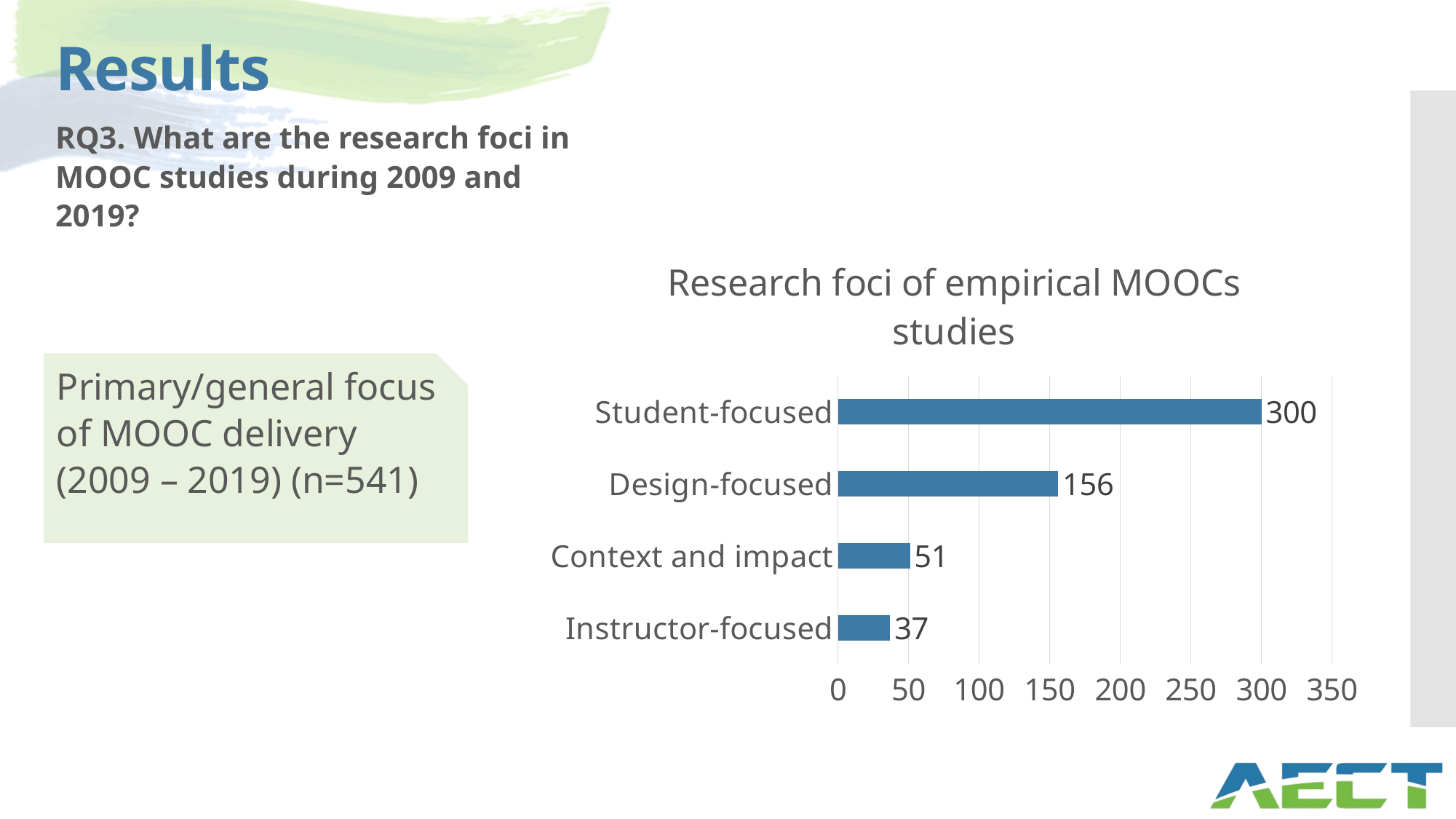
What is the value for Context and impact? 51 What is the value for Design-focused? 156 What is the value for Instructor-focused? 37 How many categories are shown in the chart? 4 Which category has the highest value? Student-focused Which category has the lowest value? Instructor-focused Which is larger, the value for Design-focused or the value for Context and impact? Design-focused What kind of chart is shown on the slide? Bar chart What is the difference between the values for Student-focused and Design-focused? 144 What is the difference between the values for Context and impact and Instructor-focused? 14 What is the value for Student-focused? 300 What is the title of the chart? Research foci of empirical MOOCs studies